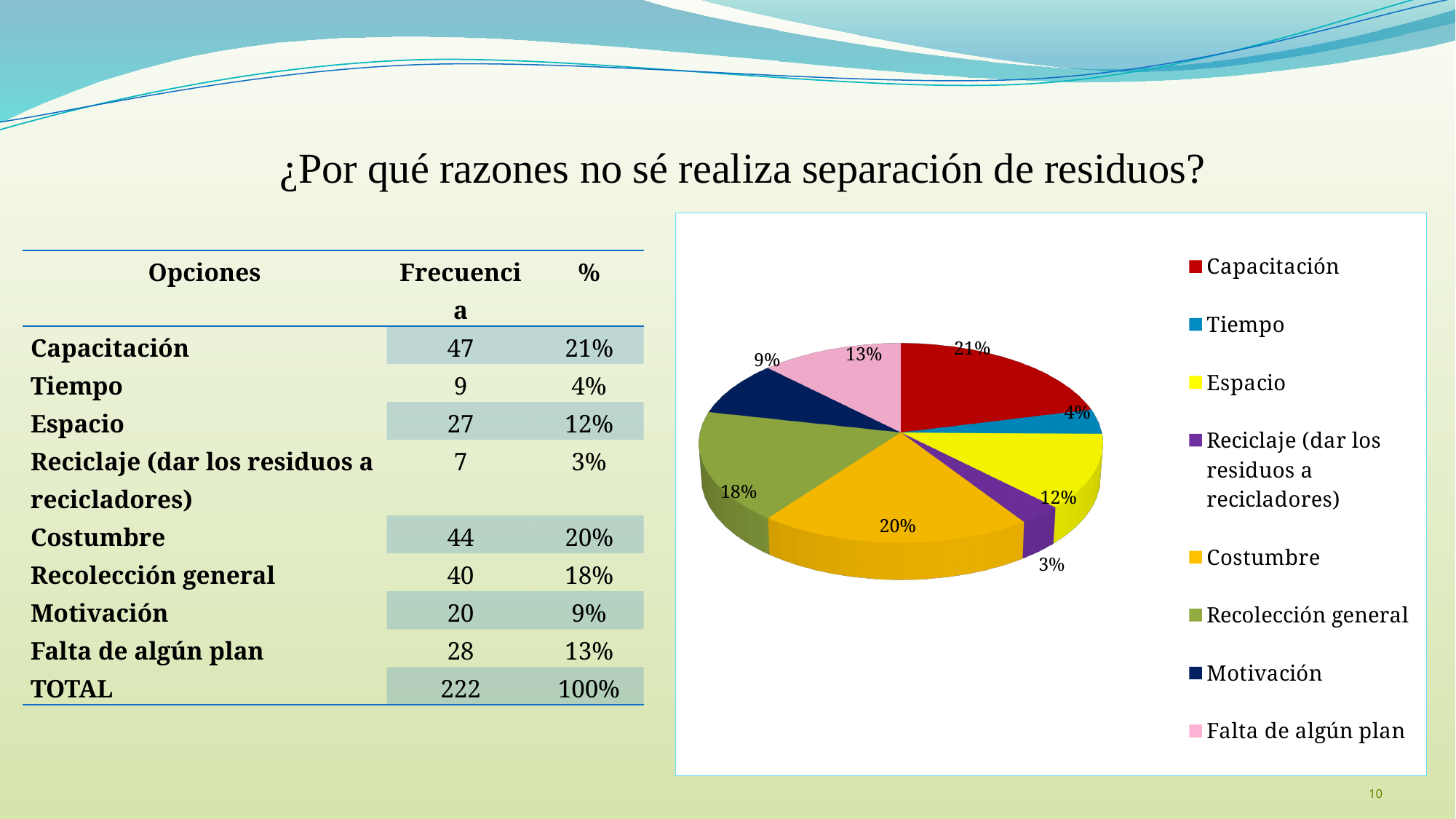
Which category has the largest slice of the pie? Capacitación What kind of chart is shown on the slide? pie chart What share of the pie does Capacitación represent? 21% What share of the pie does Costumbre represent? 20% Which legend entry is shown in pink? Falta de algún plan Which is larger, the slice for Espacio or the slice for Motivación? Espacio What share of the pie does Tiempo represent? 4% How many categories does the pie chart show? 8 Which category has the smallest slice of the pie? Reciclaje (dar los residuos a recicladores) What colour is the slice for Costumbre? orange What is the difference in percentage points between Falta de algún plan and Motivación? 4%